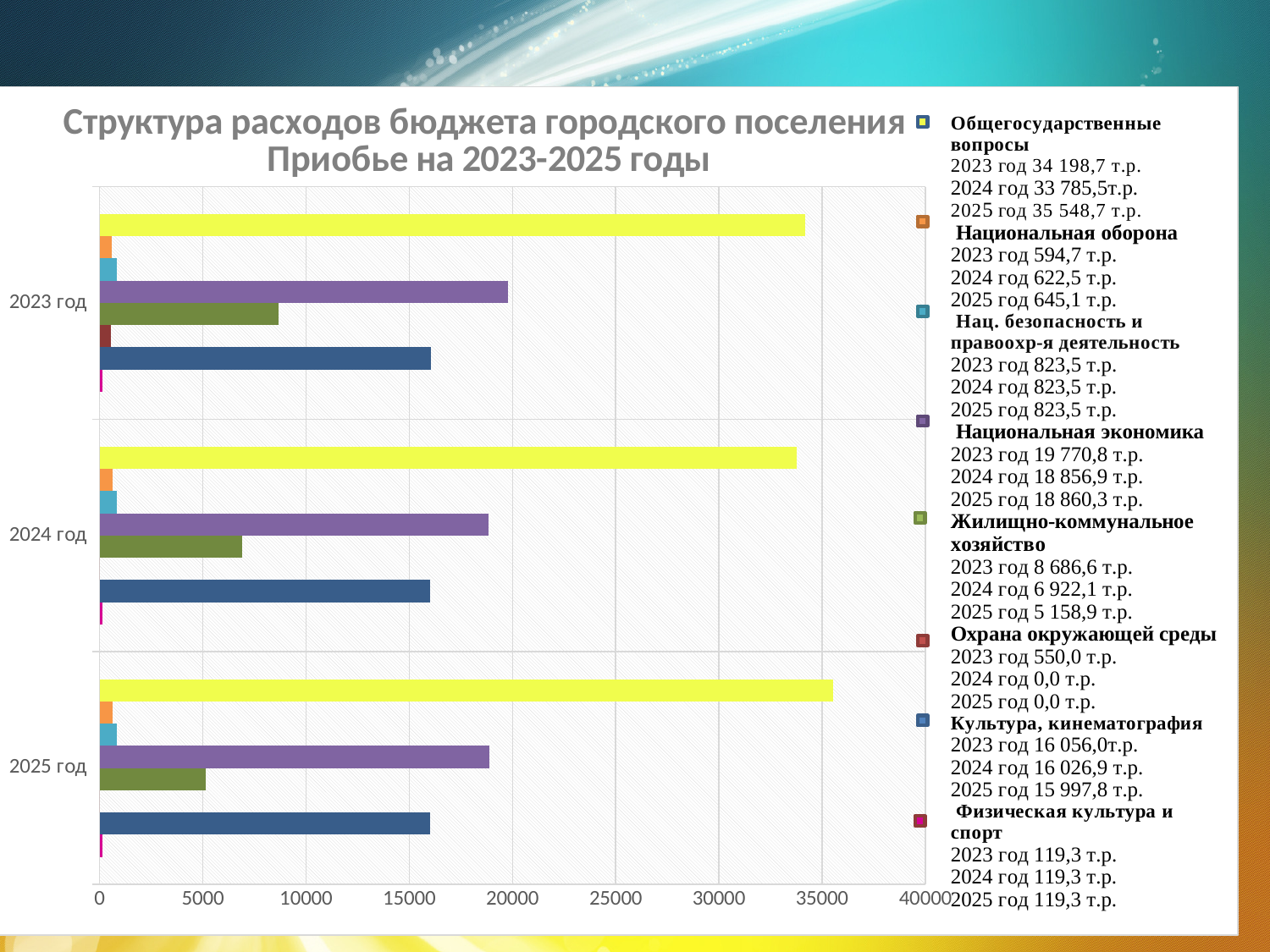
Is the value for Культура, кинематография in 2024 greater or less than 15000? greater How many year categories are plotted on the chart? 3 What kind of chart is shown on the slide? Bar chart How many series does the legend list? 8 What is the value for Общегосударственные вопросы in 2025? 35 548,7 т.р. Do the values for Жилищно-коммунальное хозяйство rise or fall from 2023 to 2025? fall What is the difference between the Общегосударственные вопросы values for 2025 and 2024? 1 763,2 т.р. Which series has the lowest value in 2023? Физическая культура и спорт Which is larger: Жилищно-коммунальное хозяйство in 2023 or in 2025? 2023 Which series has the highest value in 2023? Общегосударственные вопросы What is the value for Охрана окружающей среды in 2023? 550,0 т.р. What is the value for Национальная экономика in 2024? 18 856,9 т.р.